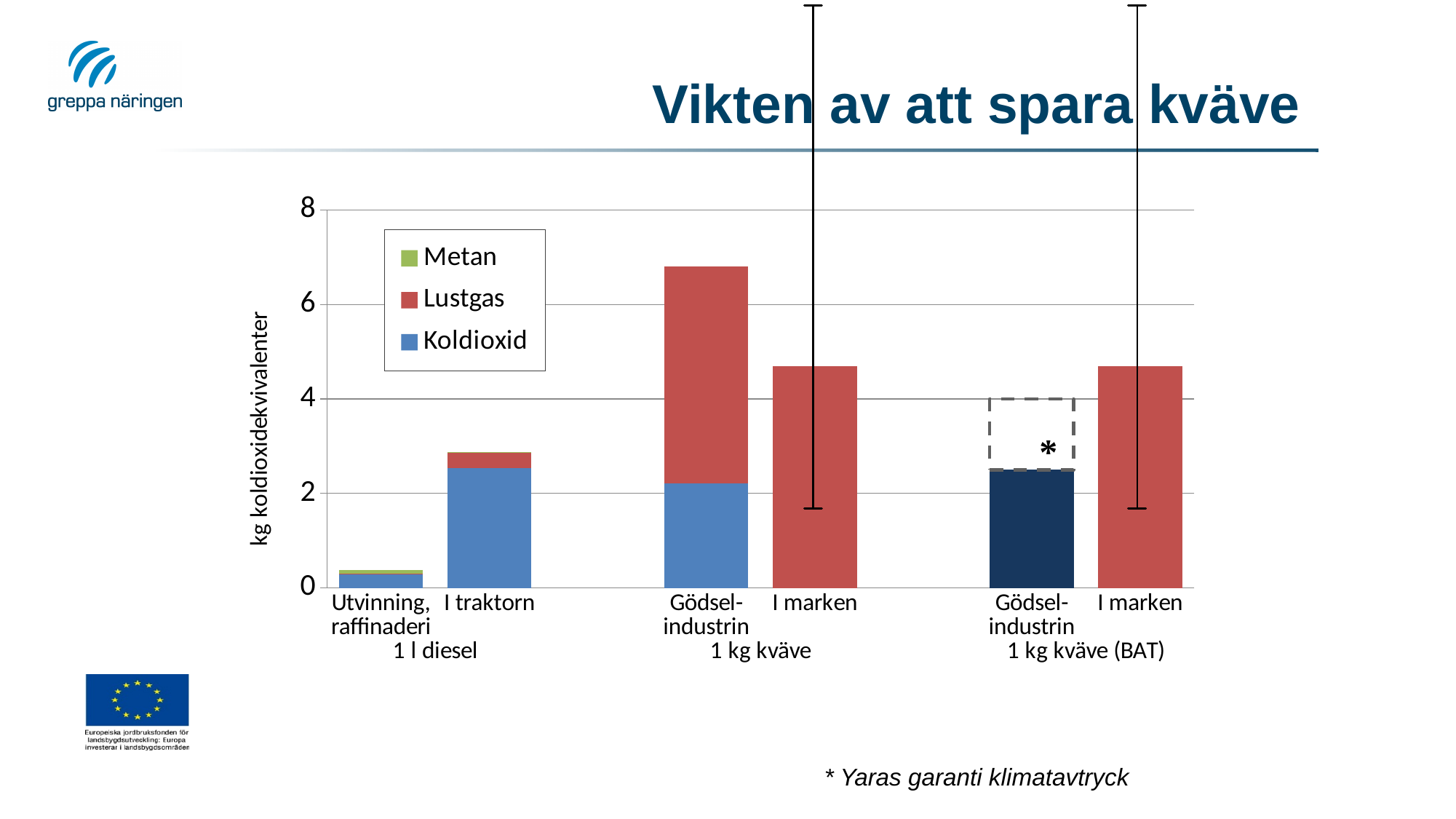
Which bar is the shortest in the chart? Utvinning, raffinaderi Which is larger, the bar for I traktorn or the bar for Utvinning, raffinaderi? I traktorn Which bar is the tallest in the chart? Gödselindustrin (1 kg kväve) Is the value for I marken under 1 kg kväve greater or less than 4? greater How many series does the legend list? 3 How many bars are plotted in the chart? 6 What is the label of the vertical axis? kg koldioxidekvivalenter Is the value for Utvinning, raffinaderi greater or less than 2? less What kind of chart is shown on the slide? Stacked bar chart Which series are listed in the legend? Metan, Lustgas, Koldioxid Under 1 kg kväve, which bar is larger, Gödselindustrin or I marken? Gödselindustrin Is the total for Gödselindustrin under 1 kg kväve greater or less than 6? greater